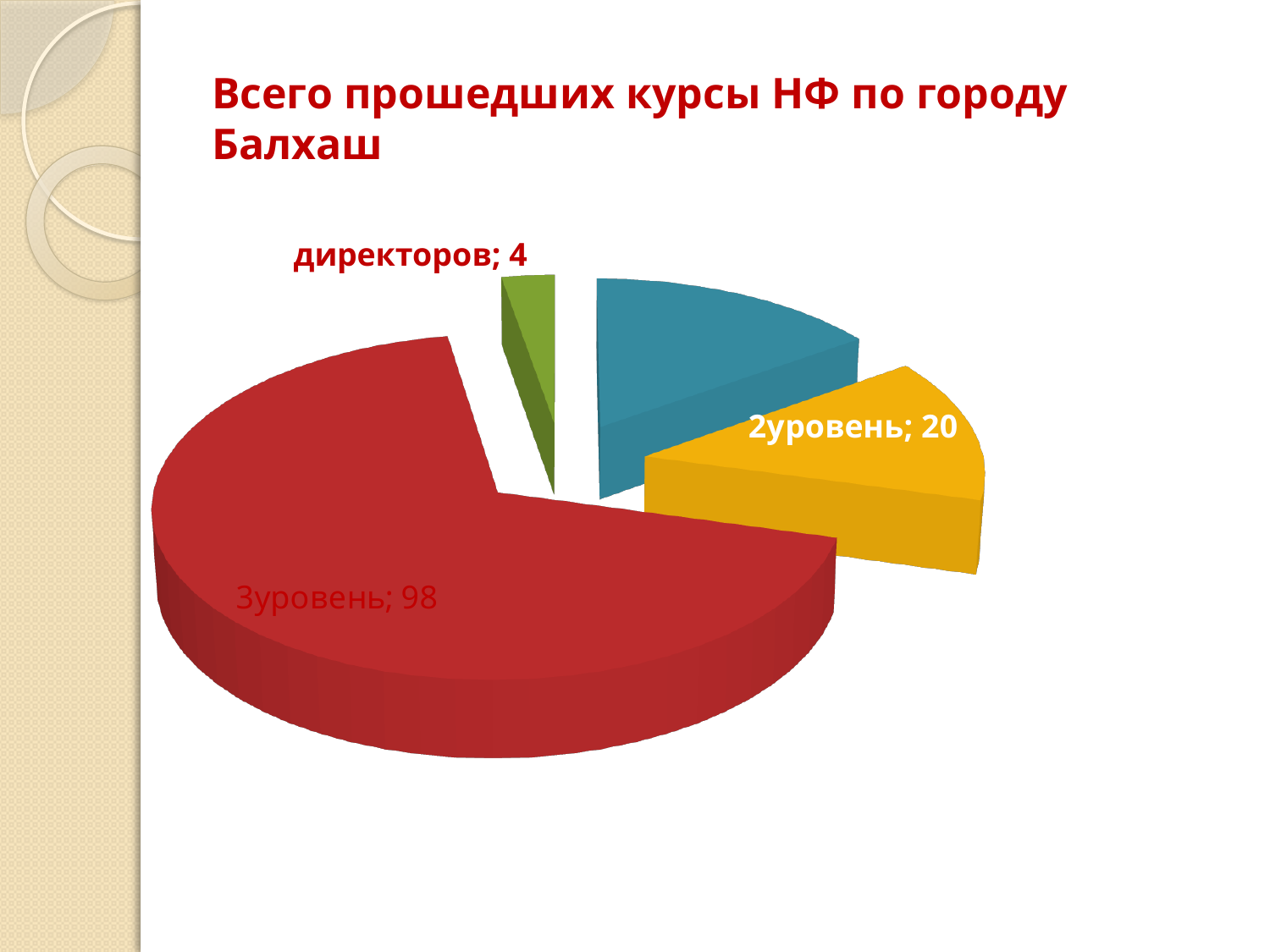
What is the difference between the values for 3уровень and 2уровень? 78 What is the difference between the values for 2уровень and директоров? 16 What type of chart is shown on the slide? pie chart What is the value for директоров? 4 What is the value for 2уровень? 20 How many slices does the pie chart have? 4 What is the value for 3уровень? 98 What colour is the slice for 3уровень? red Which is larger, the value for 2уровень or the value for директоров? 2уровень Which category has the largest slice of the pie? 3уровень Which category has the smallest slice of the pie? директоров What is the title of the slide? Всего прошедших курсы НФ по городу Балхаш